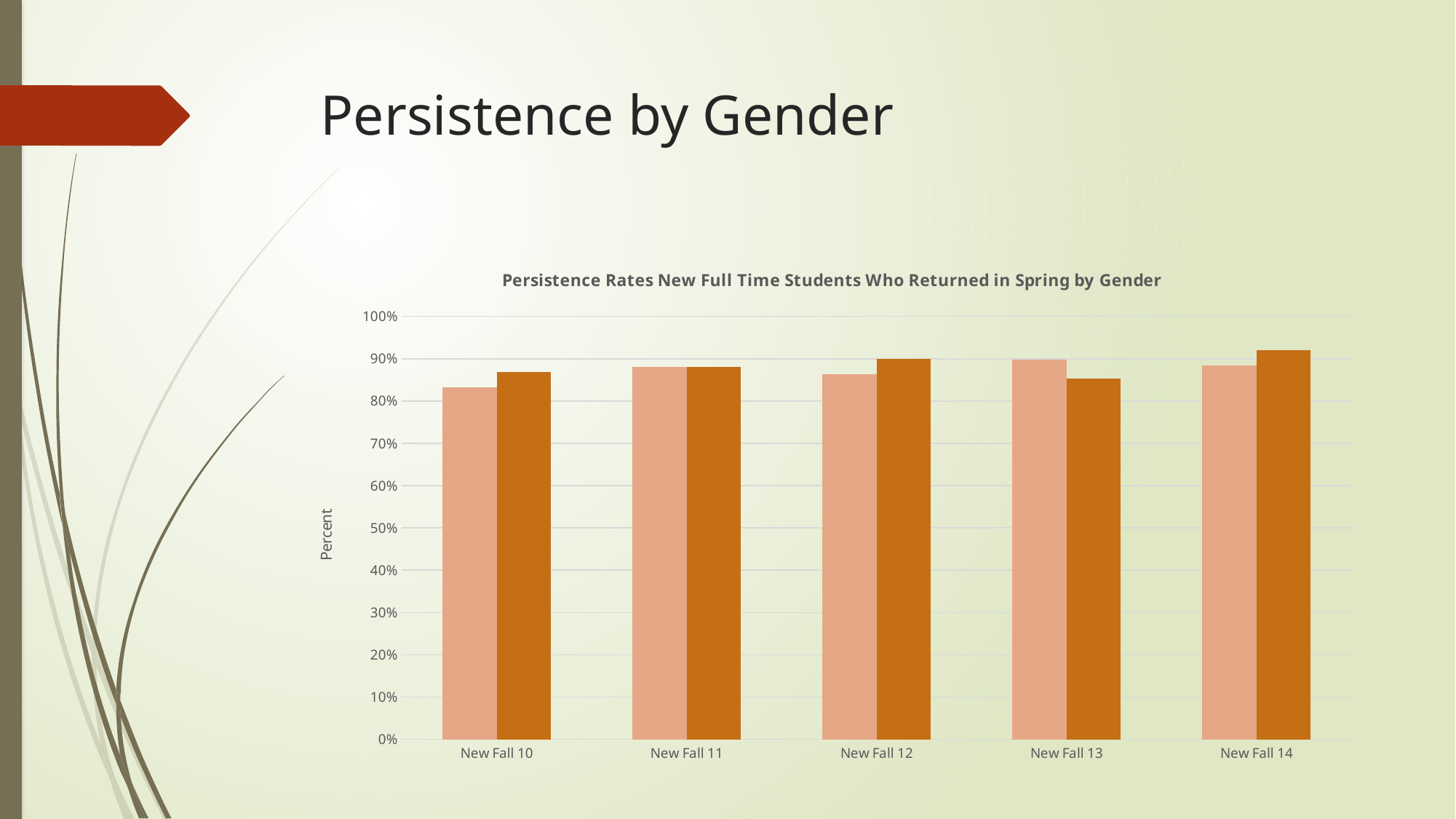
For New Fall 14, which bar is taller, the lighter orange bar or the darker orange bar? the darker orange bar What kind of chart is shown on the slide? bar chart Among the lighter orange bars, which category has the lowest value? New Fall 10 Is the darker orange bar for New Fall 13 greater or less than 90%? less What is the title of the chart? Persistence Rates New Full Time Students Who Returned in Spring by Gender How many categories are shown along the x axis of the chart? 5 For New Fall 13, which bar is taller, the lighter orange bar or the darker orange bar? the lighter orange bar Is the darker orange bar for New Fall 14 greater or less than 90%? greater What is the label on the vertical axis of the chart? Percent For New Fall 10, which bar is taller, the lighter orange bar or the darker orange bar? the darker orange bar Is the lighter orange bar for New Fall 10 greater or less than 80%? greater How many bars are plotted for each category in the chart? 2